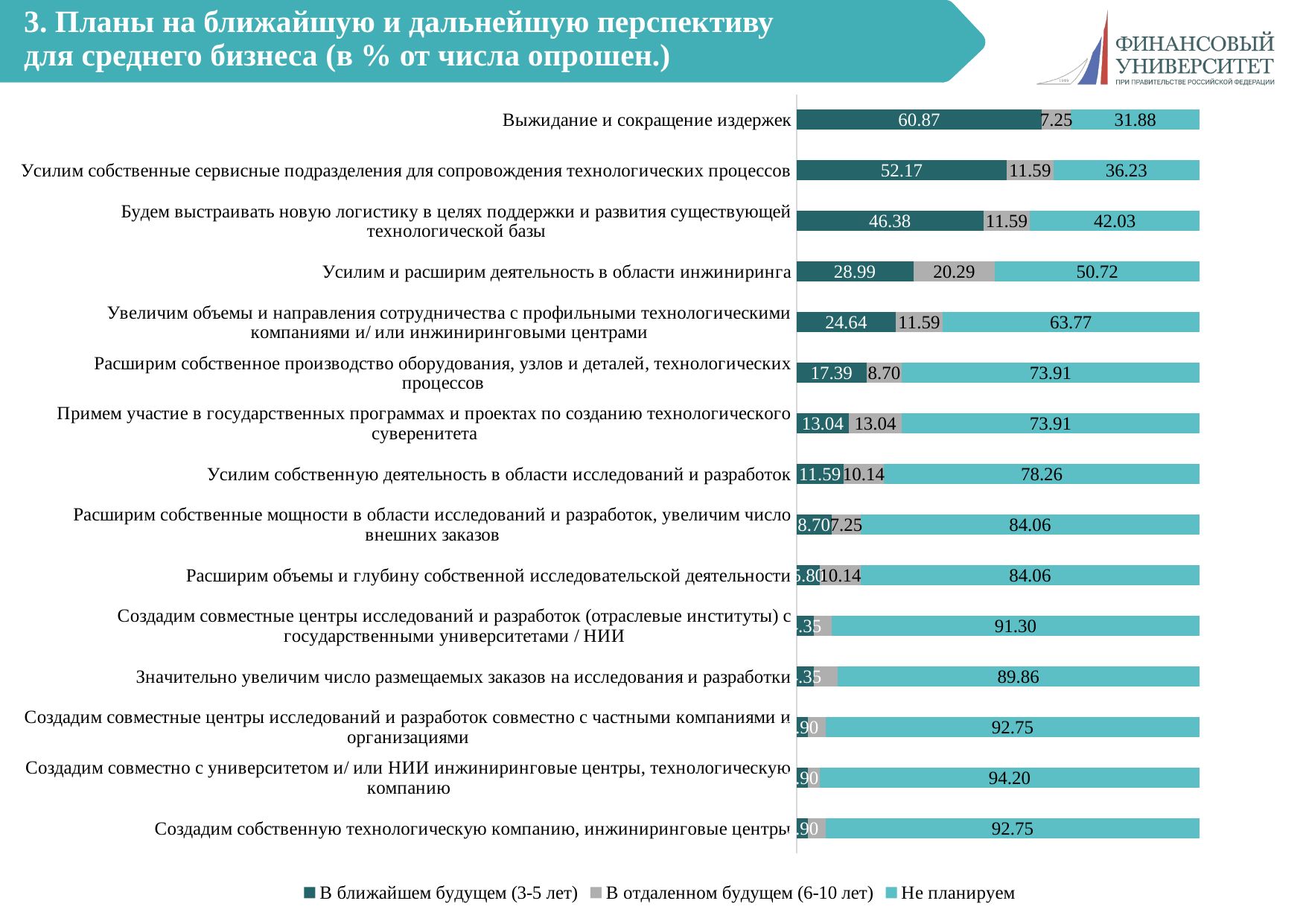
What is the value of «В ближайшем будущем (3-5 лет)» for «Выжидание и сокращение издержек»? 60.87 Which is larger: the «Не планируем» value for «Расширим собственное производство оборудования, узлов и деталей, технологических процессов» or for «Усилим собственную деятельность в области исследований и разработок»? Усилим собственную деятельность в области исследований и разработок Which legend entry is shown in the lightest (turquoise) colour? Не планируем Which category has the lowest value for «Не планируем»? Выжидание и сокращение издержек What is the value of «В отдаленном будущем (6-10 лет)» for «Усилим собственные сервисные подразделения для сопровождения технологических процессов»? 11.59 Which category has the highest value for «Не планируем»? Создадим совместно с университетом и/ или НИИ инжиниринговые центры, технологическую компанию What is the difference between the «В ближайшем будущем (3-5 лет)» values for «Выжидание и сокращение издержек» and «Усилим собственные сервисные подразделения для сопровождения технологических процессов»? 8.70 What is the value of «Не планируем» for «Усилим и расширим деятельность в области инжиниринга»? 50.72 How many categories (plans) are plotted in the chart? 15 How many series does the legend list? 3 Which category has the highest value for «В отдаленном будущем (6-10 лет)»? Усилим и расширим деятельность в области инжиниринга What kind of chart is shown on the slide? Stacked bar chart